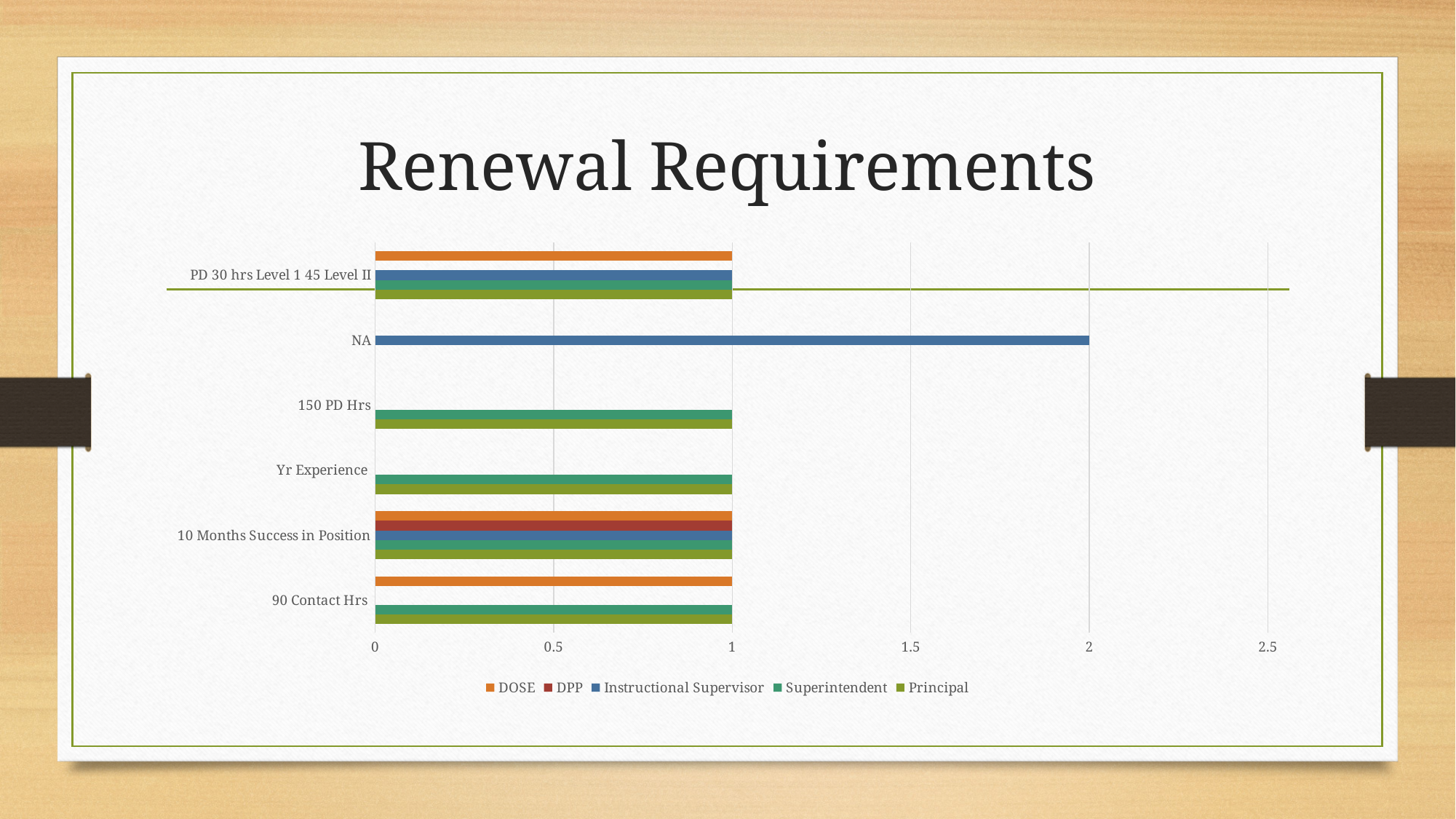
What is the value for Principal in the 150 PD Hrs category? 1 Which category is the only one where all five series have a bar? 10 Months Success in Position What is the value for Instructional Supervisor in the NA category? 2 Which is larger: the Instructional Supervisor value for NA or the Superintendent value for Yr Experience? Instructional Supervisor value for NA What is the value for DOSE in the 90 Contact Hrs category? 1 How many series does the chart legend list? 5 What is the title of the slide containing the chart? Renewal Requirements What kind of chart is shown on the slide? bar chart Which category has the longest bar in the chart? NA Is the Instructional Supervisor value for NA greater or less than 1.5? greater How many categories are listed on the vertical axis of the chart? 6 What is the difference between the Instructional Supervisor value for NA and the Instructional Supervisor value for 10 Months Success in Position? 1